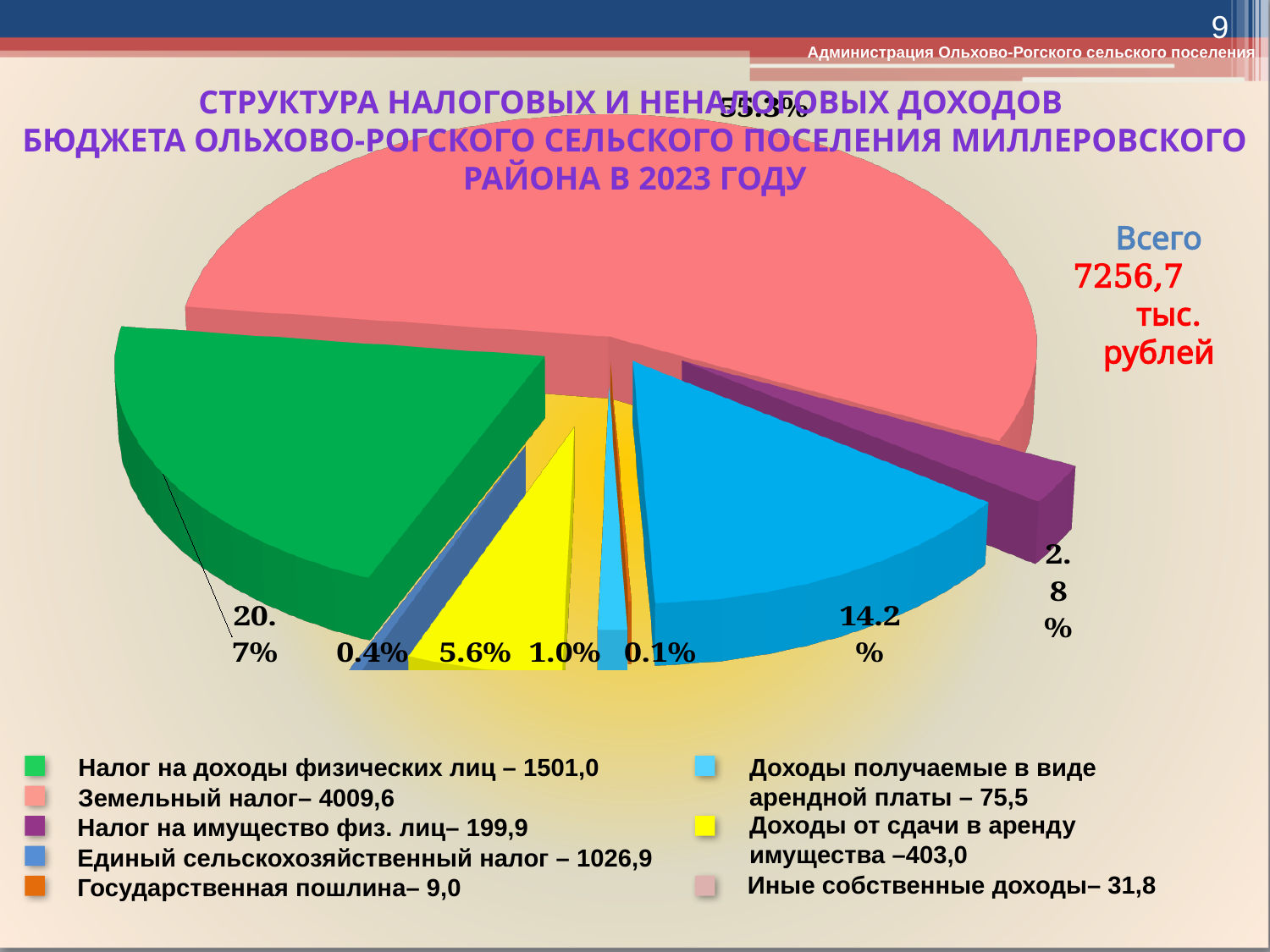
Which category has the smallest share of the pie chart? Государственная пошлина Which category has the largest share of the pie chart? Земельный налог How many categories does the legend of the pie chart list? 8 What kind of chart is shown on the slide? pie chart Which is larger: Налог на имущество физ. лиц or Доходы от сдачи в аренду имущества? Доходы от сдачи в аренду имущества What share of the pie does Единый сельскохозяйственный налог represent? 14.2% What is the total (Всего) shown on the slide? 7256,7 тыс. рублей What value is given in the legend for Земельный налог? 4009,6 What value is given in the legend for Единый сельскохозяйственный налог? 1026,9 What is the difference between the legend values for Земельный налог and Налог на доходы физических лиц? 2508,6 What share of the pie does Земельный налог represent? 55.3% What share of the pie does Налог на доходы физических лиц represent? 20.7%